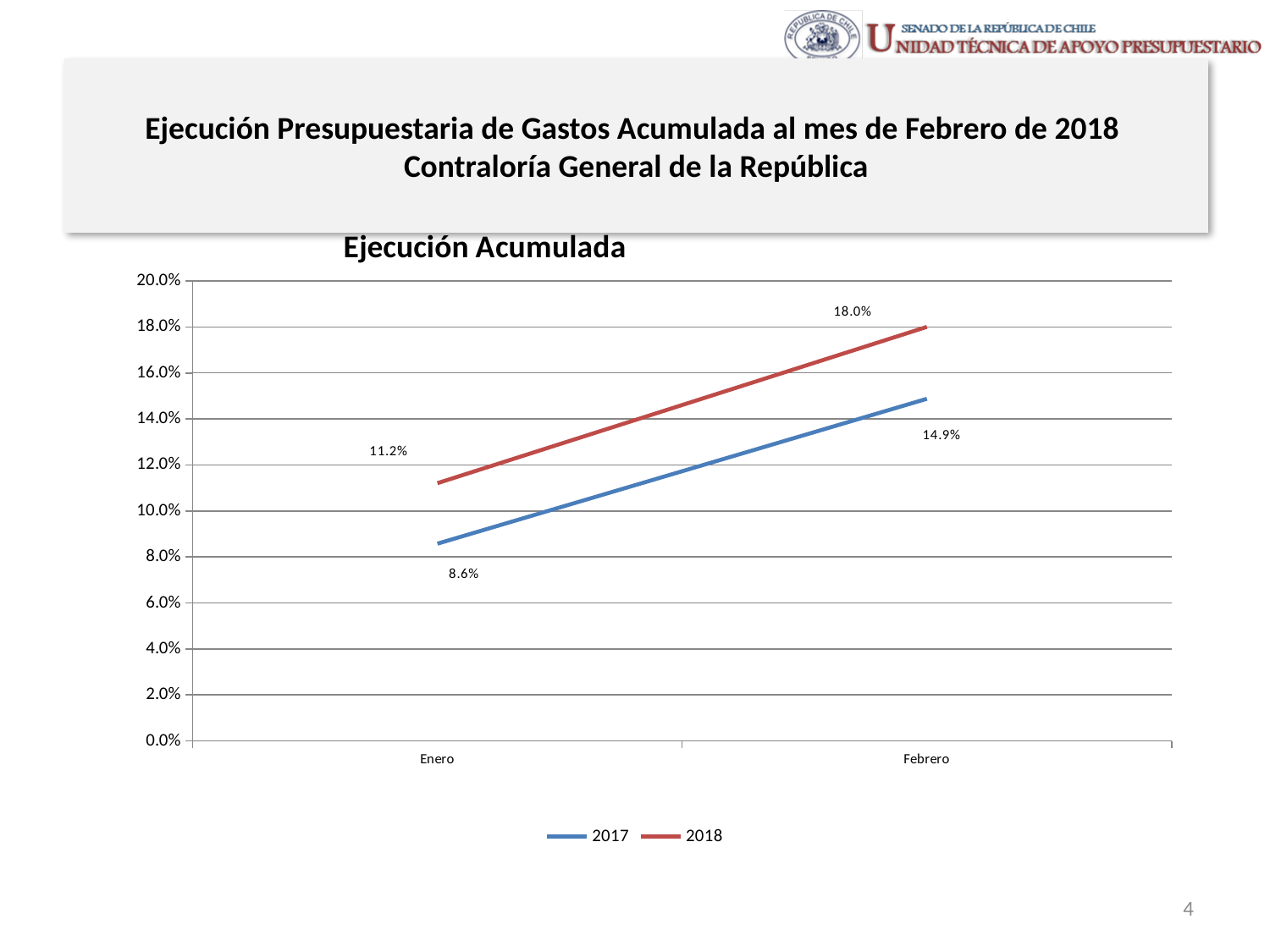
What is the value for 2018 in Febrero? 18.0% What is the title of the chart? Ejecución Acumulada How many categories are shown on the x axis? 2 What is the value for 2018 in Enero? 11.2% What kind of chart is shown? line chart Does the 2017 series rise or fall from Enero to Febrero? rise What is the value for 2017 in Febrero? 14.9% Which series has the higher value in Febrero, 2017 or 2018? 2018 What is the value for 2017 in Enero? 8.6% What is the difference between the 2018 and 2017 values in Enero? 2.6% What is the difference between the 2018 and 2017 values in Febrero? 3.1% How many series does the legend list? 2